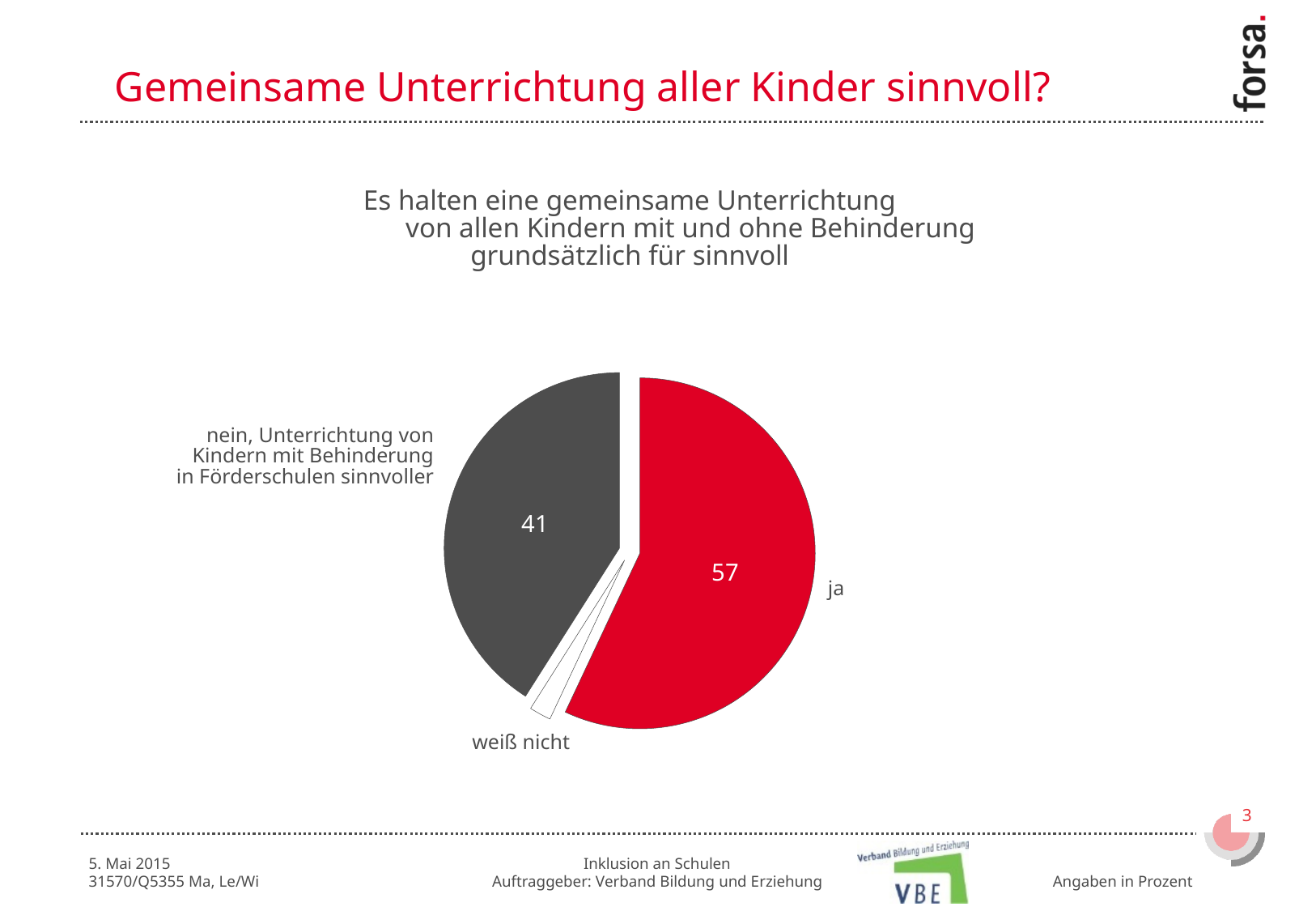
What is the difference between the "ja" value and the "nein" value? 16 In what unit are the values in the chart given, according to the note at the bottom right? Prozent What is the title of the slide? Gemeinsame Unterrichtung aller Kinder sinnvoll? Which category has the largest slice in the pie chart? ja Which is larger, the "ja" slice or the "nein" slice? ja What value is shown for the slice "nein, Unterrichtung von Kindern mit Behinderung in Förderschulen sinnvoller"? 41 What kind of chart is shown on the slide? pie chart Which category has the smallest slice in the pie chart? weiß nicht What value is shown for the "ja" slice of the pie chart? 57 What colour is the "ja" slice? red How many slices does the pie chart have? 3